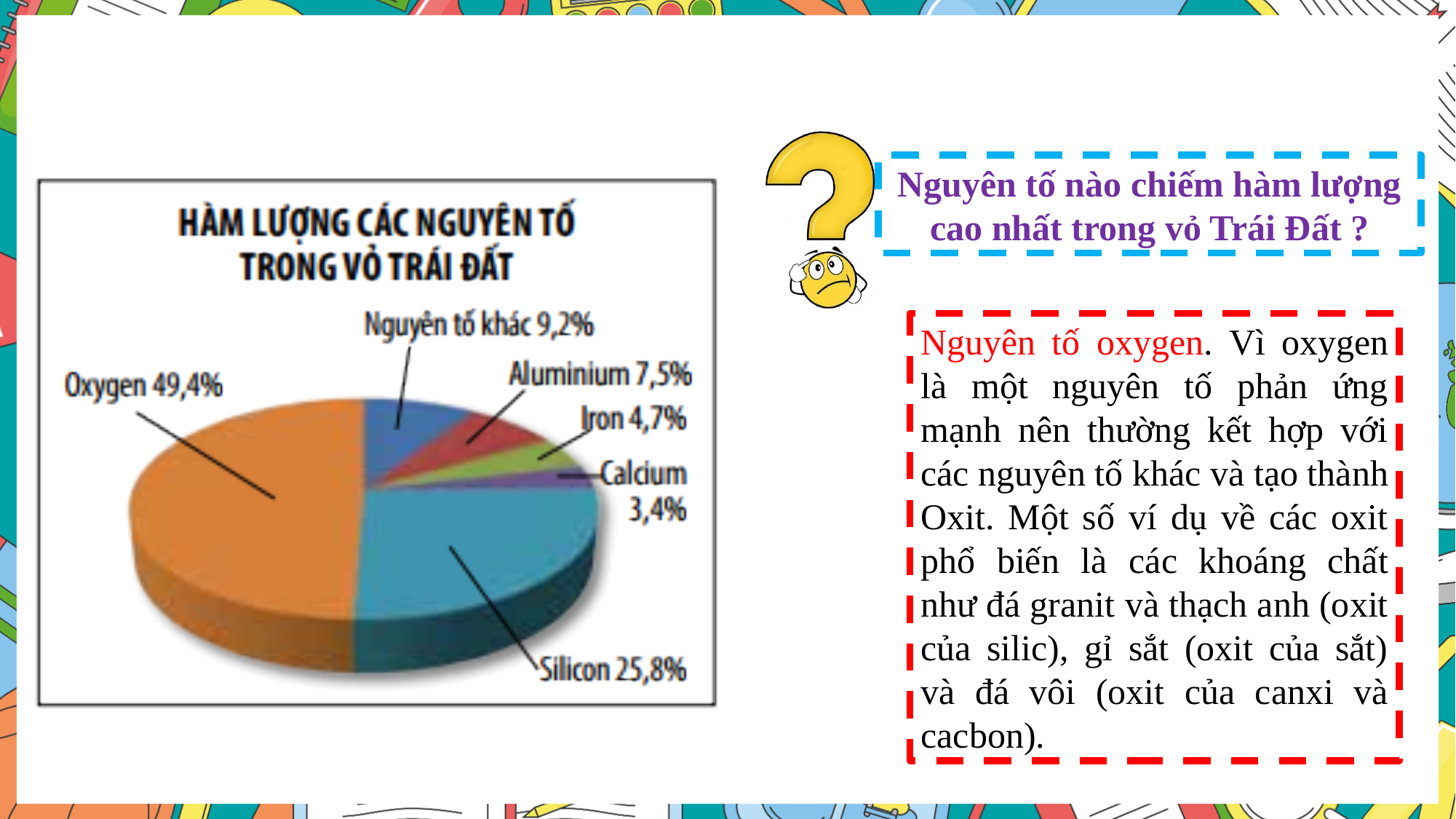
Which is larger, the share for Aluminium or the share for Iron? Aluminium What is the value for Iron? 4,7% What is the value shown for Silicon? 25,8% What is the difference between the Oxygen and Silicon percentages? 23,6% How many slices does the pie chart have? 6 What share of the pie does Oxygen have? 49,4% What is the value for Calcium? 3,4% What percentage is labelled for Aluminium? 7,5% What percentage is shown for 'Nguyên tố khác'? 9,2% What type of chart is shown on the slide? Pie chart Which element has the largest slice of the pie? Oxygen Which category has the smallest slice of the pie? Calcium